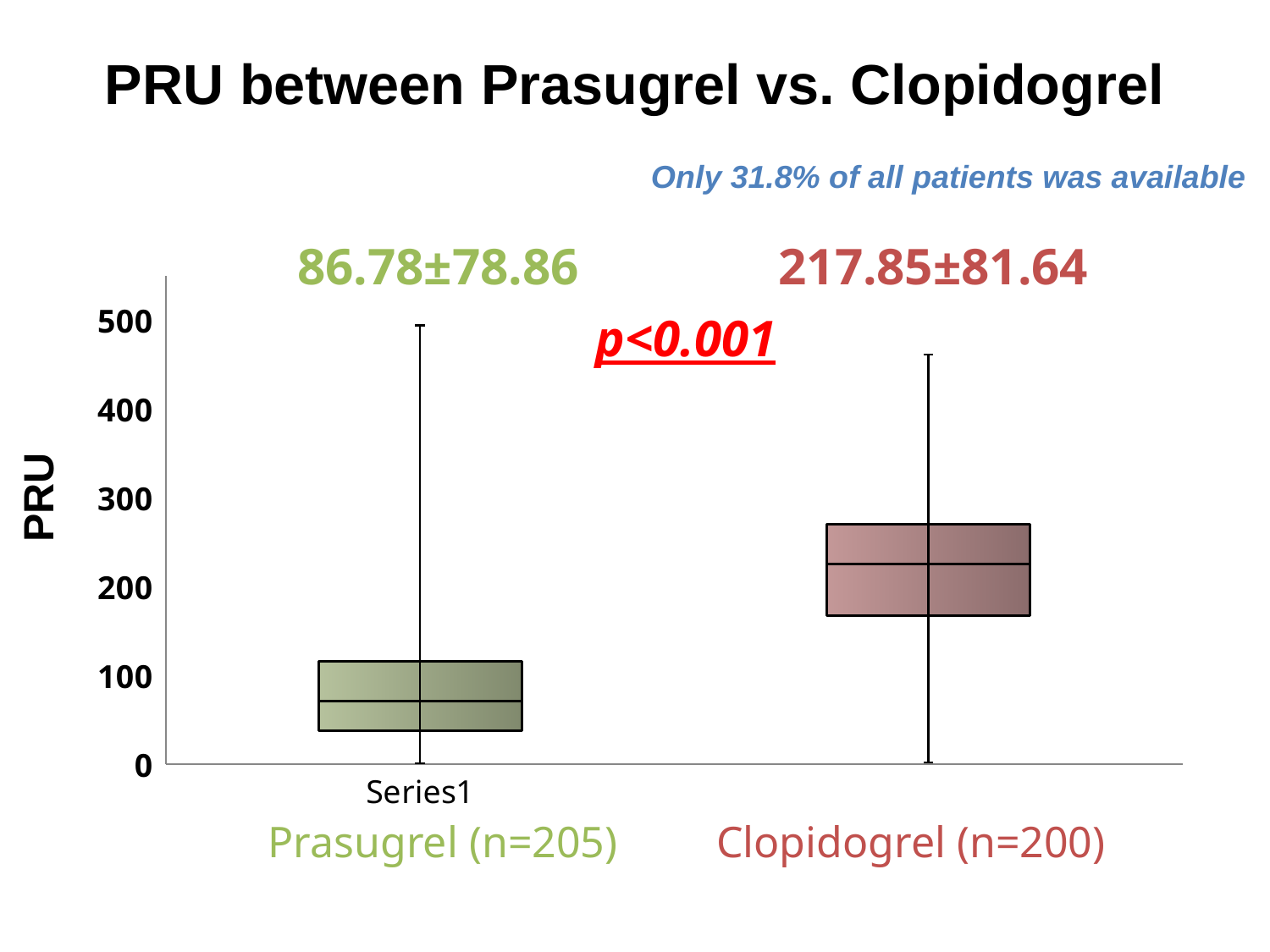
Is the median line of the Prasugrel box greater or less than 100? less What is the sample size (n) of the Clopidogrel group? 200 What value (mean ± SD) is printed above the Prasugrel group? 86.78±78.86 What is the difference between the mean PRU of Clopidogrel (217.85) and Prasugrel (86.78)? 131.07 How many treatment groups are plotted on the chart? 2 What value (mean ± SD) is printed above the Clopidogrel group? 217.85±81.64 What kind of chart is shown on the slide? Box plot Is the median line of the Clopidogrel box greater or less than 200? greater Which group has the lowest mean PRU? Prasugrel What is the title of the chart? PRU between Prasugrel vs. Clopidogrel Which group has the higher mean PRU, Prasugrel or Clopidogrel? Clopidogrel What p-value is printed on the chart for the comparison between the two groups? p<0.001